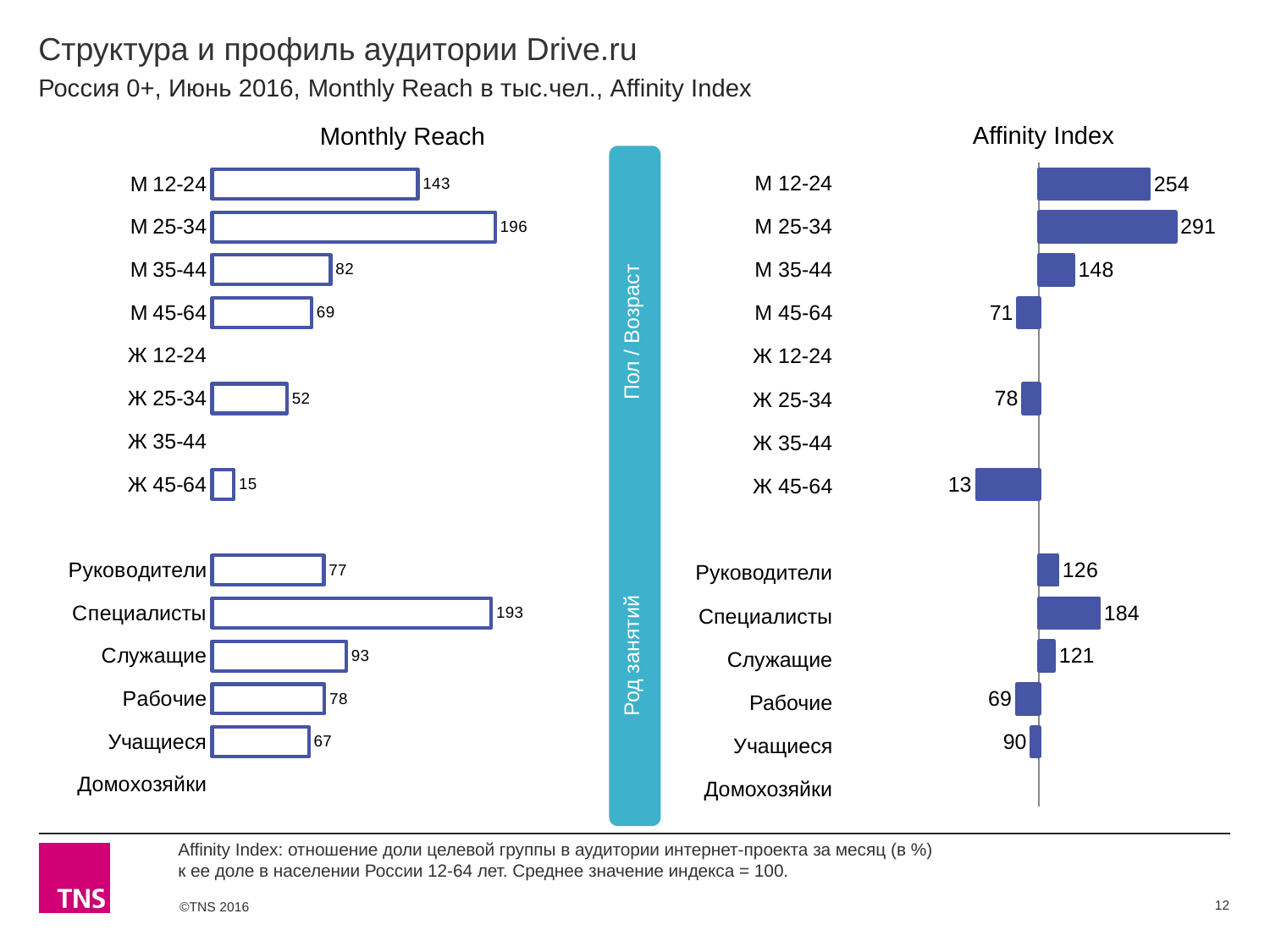
In the Monthly Reach chart, what is the value for Учащиеся? 67 What type of chart is the Affinity Index chart? Bar chart In the Monthly Reach chart, which category has the highest value? М 25-34 In the Affinity Index chart, what is the value for Специалисты? 184 In the Monthly Reach chart, what is the value for М 25-34? 196 In the Affinity Index chart, which is larger: Руководители or Учащиеся? Руководители In the Monthly Reach chart, what is the difference between М 12-24 and М 35-44? 61 In the Monthly Reach chart, which is larger: Служащие or Рабочие? Служащие In the Affinity Index chart, which category has the lowest value? Ж 45-64 In the Affinity Index chart, what is the difference between М 12-24 and М 35-44? 106 In the Affinity Index chart, which category has the highest value? М 25-34 In the Monthly Reach chart, what is the value for Ж 45-64? 15